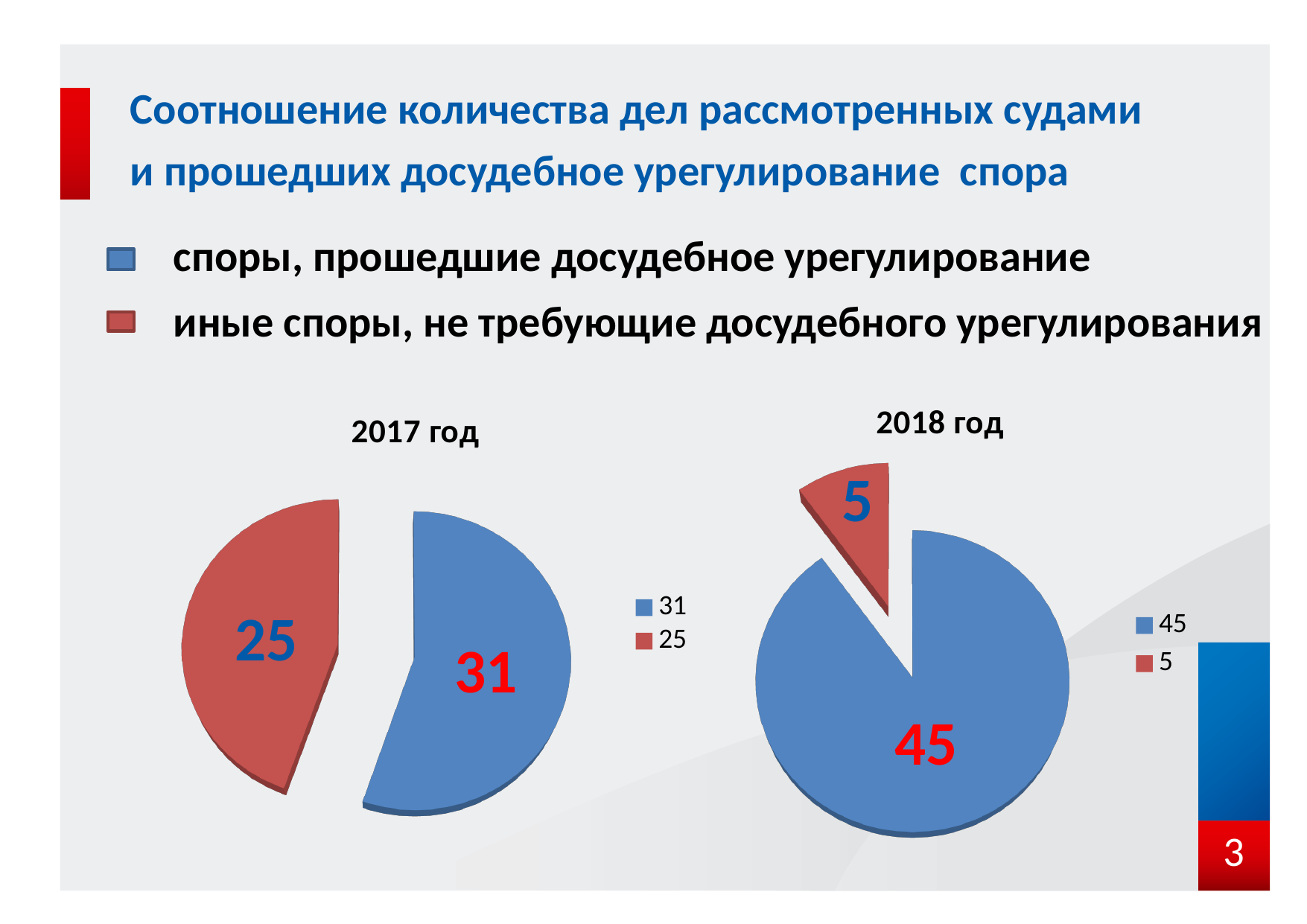
In the 2017 год chart, what is the value of the blue slice (споры, прошедшие досудебное урегулирование)? 31 Which colour represents споры, прошедшие досудебное урегулирование in the charts? blue In the 2018 год chart, what is the value of the blue slice (споры, прошедшие досудебное урегулирование)? 45 In the 2018 год chart, what share of the total does the red slice (5) represent? 10% In the 2017 год chart, what is the value of the red slice (иные споры, не требующие досудебного урегулирования)? 25 In the 2018 год chart, what is the value of the red slice (иные споры, не требующие досудебного урегулирования)? 5 In the 2018 год chart, which slice is larger, the blue one or the red one? the blue one (45) How many slices does the 2017 год pie chart have? 2 In the 2018 год chart, what is the difference between the blue slice and the red slice? 40 In the 2017 год chart, what is the difference between the blue slice and the red slice? 6 What type of chart is used for the 2017 год chart? pie chart How many entries does the legend of the 2018 год chart list? 2